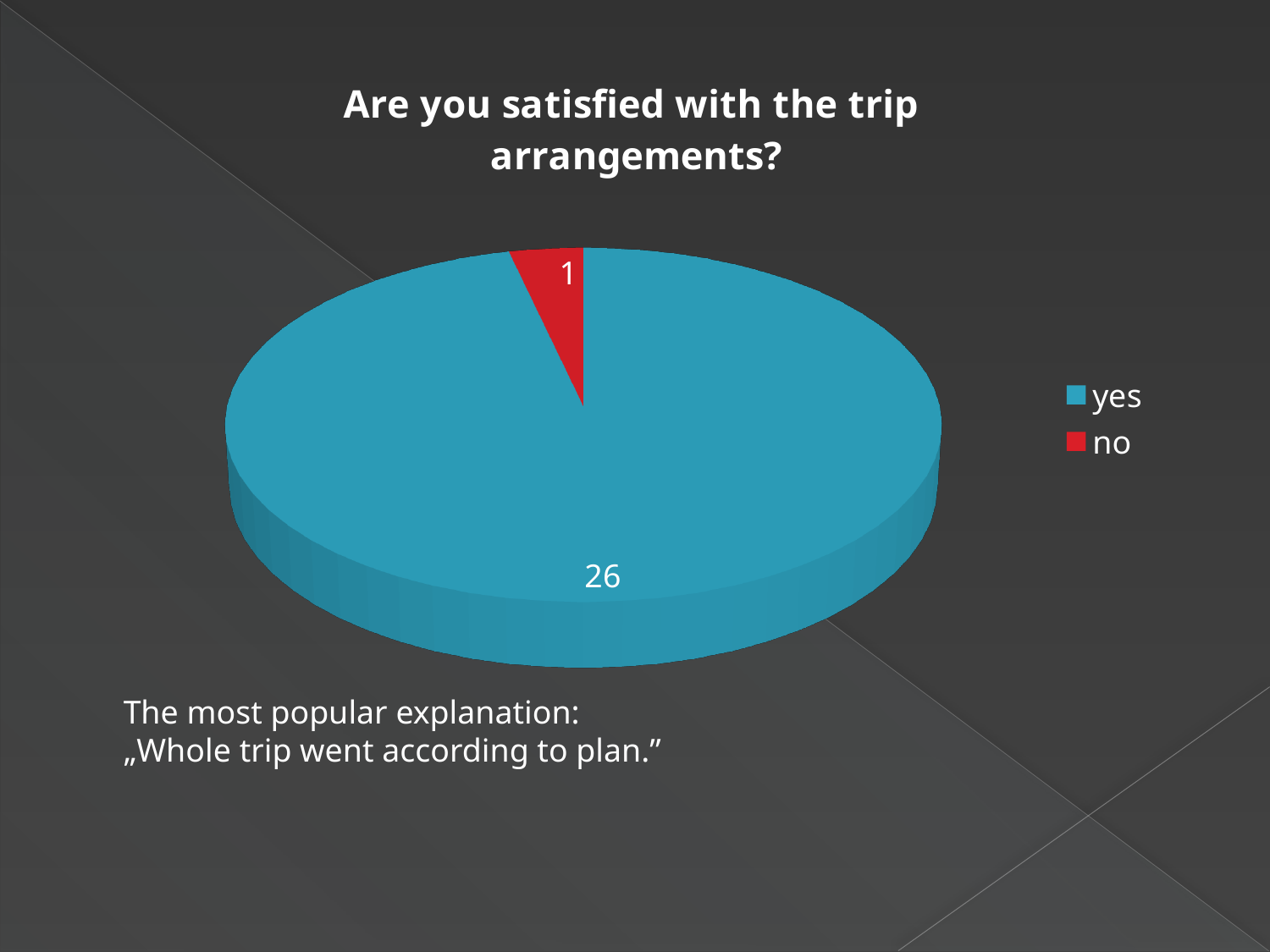
What kind of chart is shown on the slide? pie chart What is the value for "no"? 1 Which is larger, the value for "yes" or the value for "no"? yes How many categories does the pie chart have? 2 What is the title of the chart? Are you satisfied with the trip arrangements? What is the value for "yes"? 26 What is the difference between the values for "yes" and "no"? 25 How many entries does the legend list? 2 What is the total of all slices in the pie chart? 27 What colour is the "no" slice? red Which category has the largest slice? yes Which category has the smallest slice? no